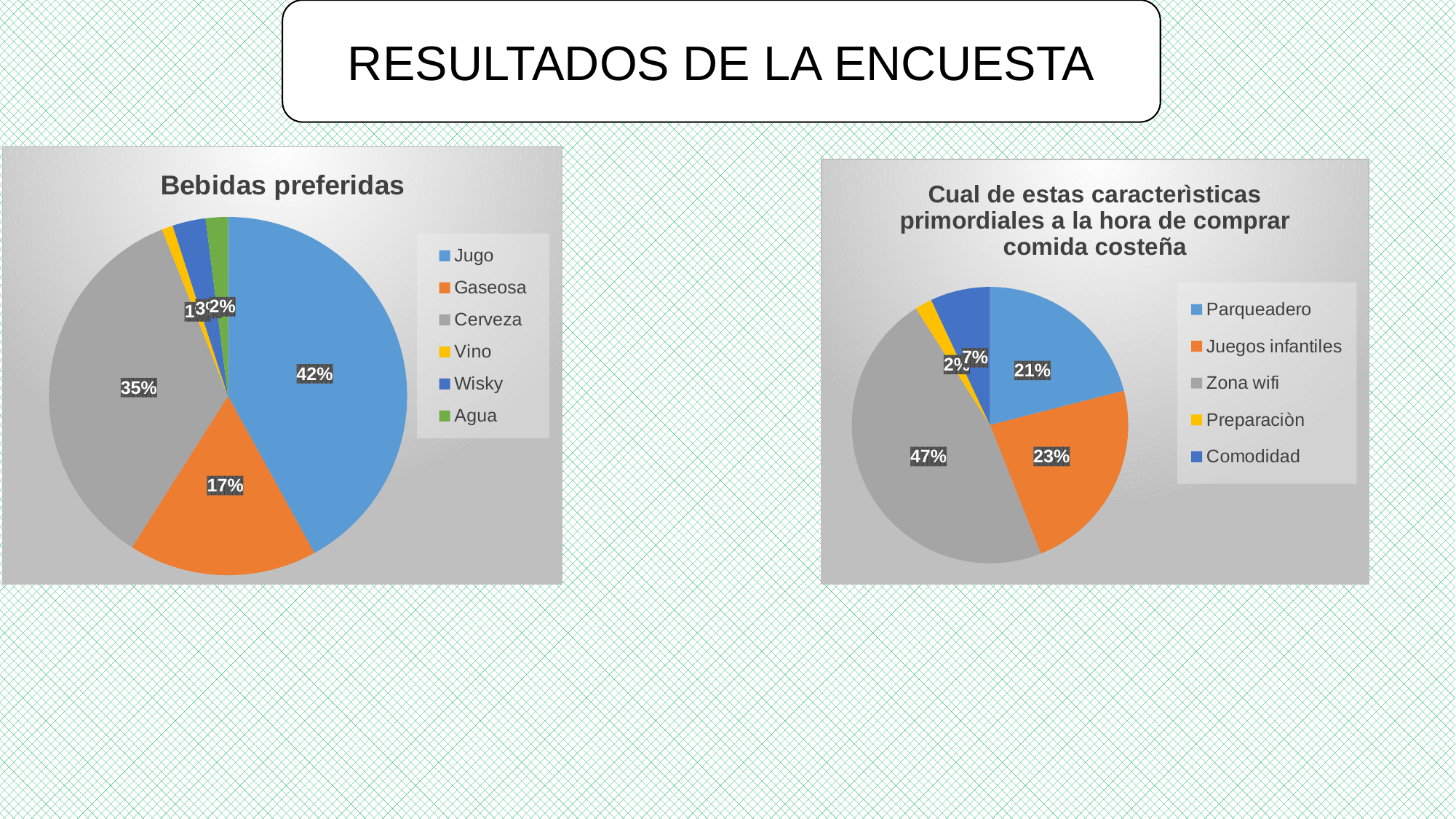
In the 'Bebidas preferidas' chart, what percentage is shown for Cerveza? 35% In the chart on the right about characteristics when buying comida costeña, what percentage is shown for Juegos infantiles? 23% In the 'Bebidas preferidas' chart, what percentage is shown for Gaseosa? 17% In the 'Bebidas preferidas' chart, what is the difference between the Jugo and Cerveza shares? 7% What type of chart is the 'Bebidas preferidas' chart? Pie chart In the chart on the right about characteristics when buying comida costeña, which category has the largest share? Zona wifi In the chart on the right about characteristics when buying comida costeña, which is larger: Juegos infantiles or Parqueadero? Juegos infantiles In the 'Bebidas preferidas' chart, which drink has the largest share? Jugo In the chart on the right about characteristics when buying comida costeña, what percentage is shown for Parqueadero? 21% In the 'Bebidas preferidas' chart, how many categories does the legend list? 6 In the 'Bebidas preferidas' chart, what percentage is shown for Jugo? 42% In the chart on the right about characteristics when buying comida costeña, what percentage is shown for Zona wifi? 47%